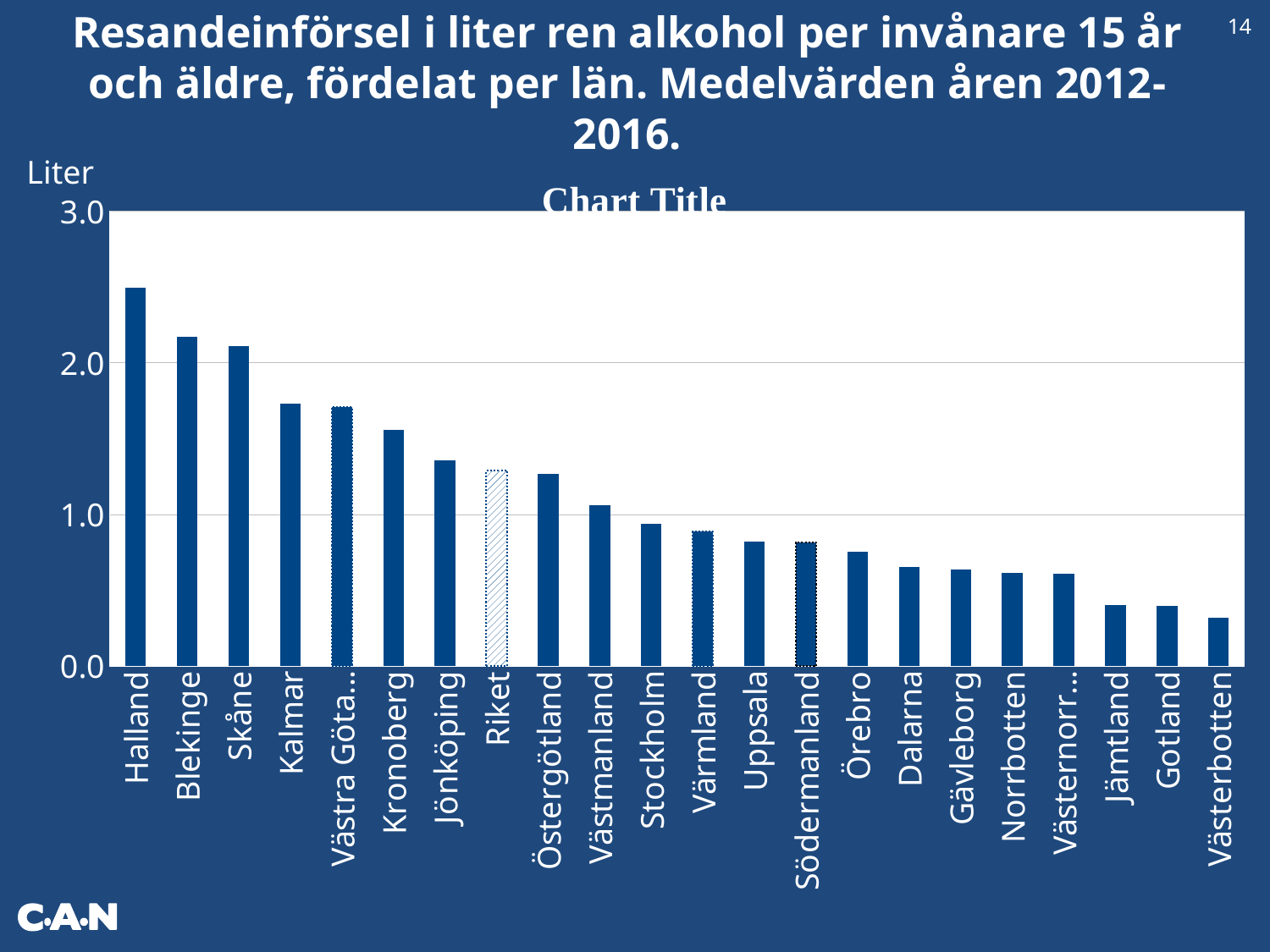
Which is larger, the value for Halland or the value for Skåne? Halland Is the value for Halland greater or less than 2.0? greater What kind of chart is shown on the slide? Bar chart What is the label shown on the vertical axis of the chart? Liter Is the value for Stockholm greater or less than 1.0? less Which category has the lowest value in the chart? Västerbotten Is the value for Riket greater or less than 1.0? greater Which is larger, the value for Kalmar or the value for Kronoberg? Kalmar Which county has the highest value in the chart? Halland Do the values rise or fall from left to right along the x axis? Fall